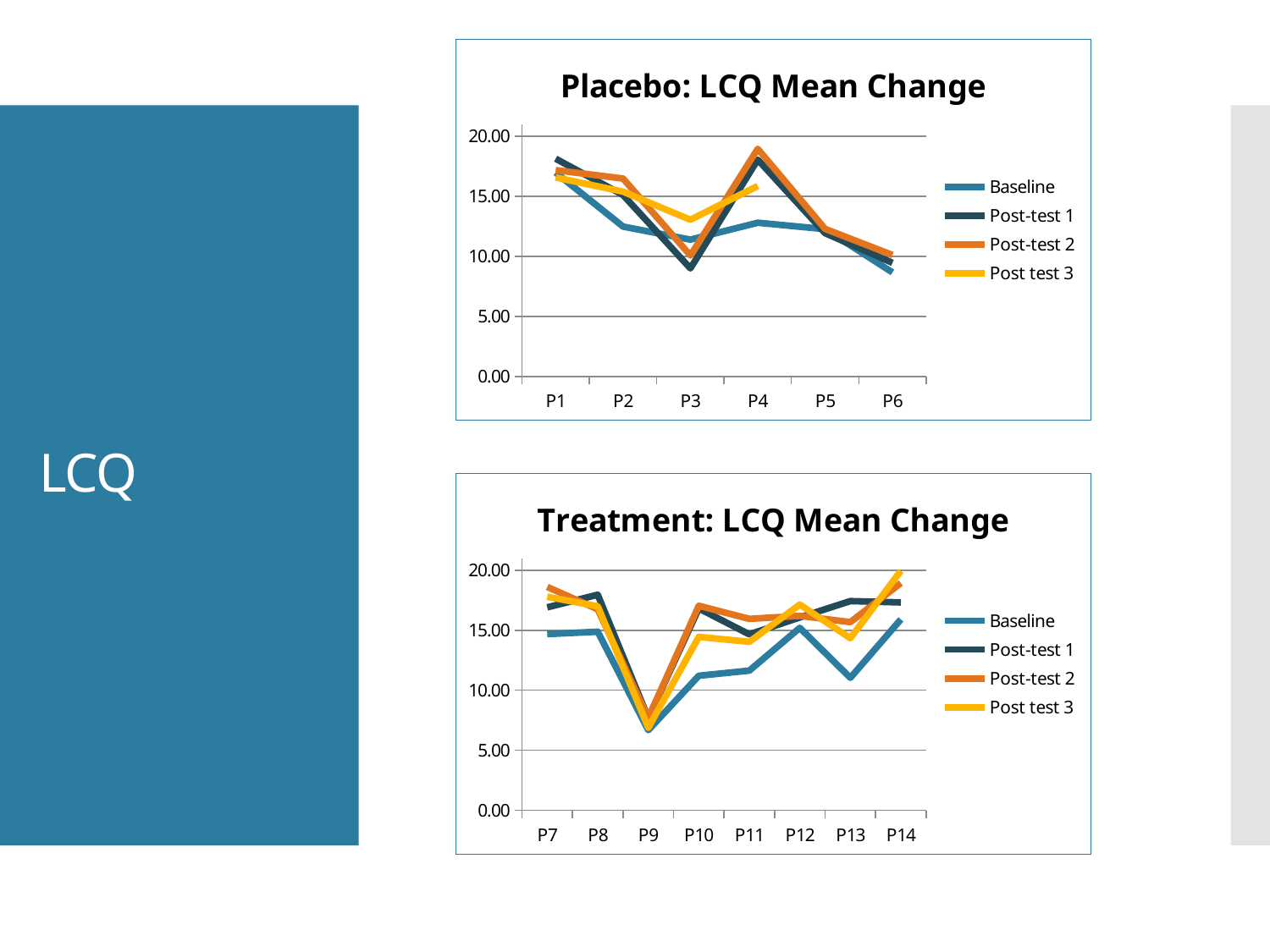
In the "Treatment: LCQ Mean Change" chart, which participant has the lowest Baseline value? P9 How many participants (categories) are shown on the x axis of the "Placebo: LCQ Mean Change" chart? 6 In the "Treatment: LCQ Mean Change" chart, is the Baseline value for P9 greater or less than 10.00? less In the "Placebo: LCQ Mean Change" chart, is the Post-test 2 value for P4 greater or less than 15.00? greater In the "Placebo: LCQ Mean Change" chart, is the Post-test 1 value for P3 greater or less than 10.00? less What is the title of the lower chart on the slide? Treatment: LCQ Mean Change What type of chart is the "Placebo: LCQ Mean Change" chart? Line chart How many series does the legend of the "Placebo: LCQ Mean Change" chart list? 4 In the "Treatment: LCQ Mean Change" chart, at P10, which is larger: the Post-test 2 value or the Baseline value? Post-test 2 In the "Placebo: LCQ Mean Change" chart, at P3, which is larger: the Baseline value or the Post-test 1 value? Baseline In the "Placebo: LCQ Mean Change" chart, which participant has the lowest Post-test 1 value? P3 How many participants (categories) are shown on the x axis of the "Treatment: LCQ Mean Change" chart? 8